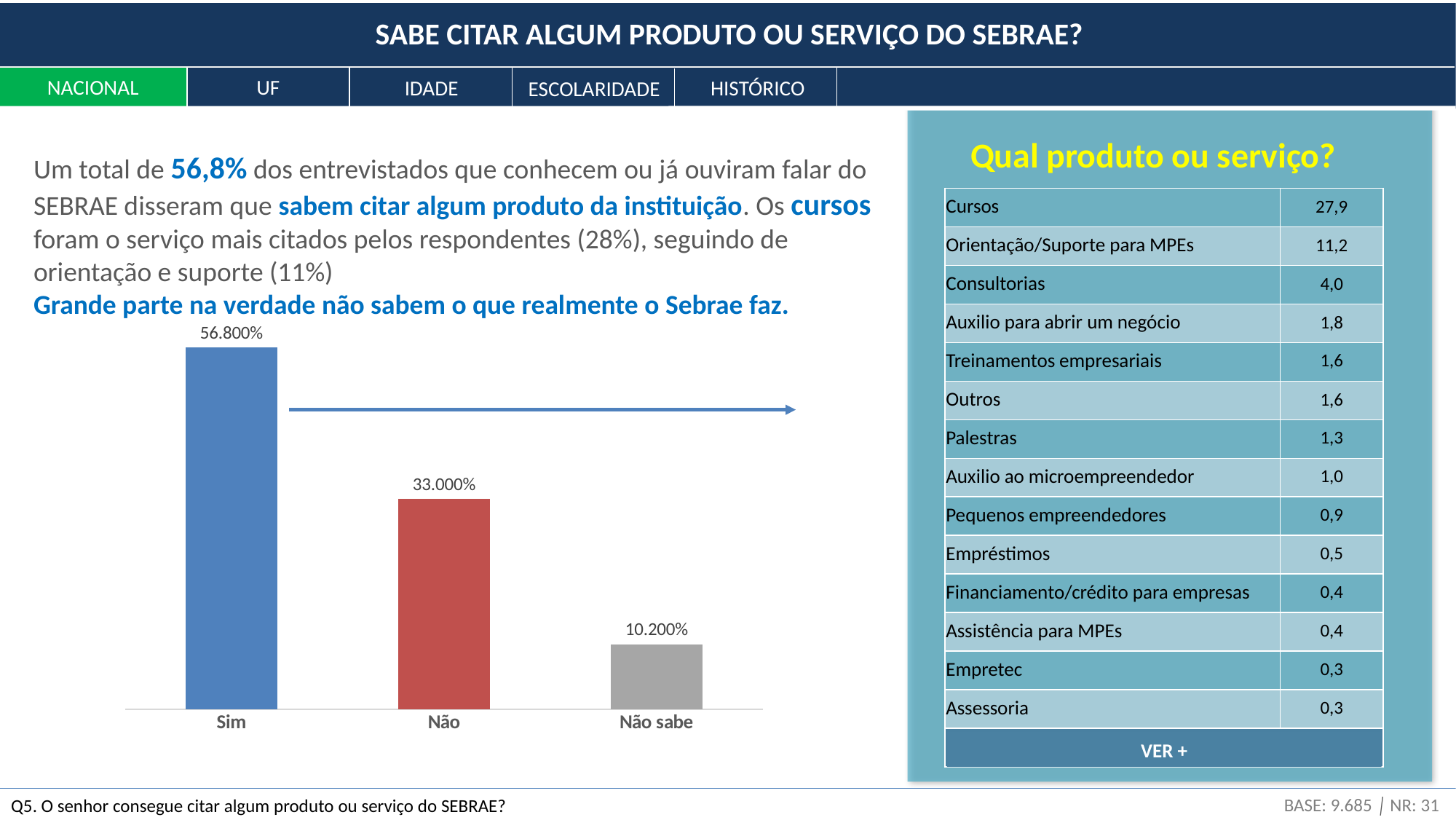
Which is larger in the bar chart, the value for "Não" or the value for "Não sabe"? Não What is the difference between the values for "Sim" and "Não" in the bar chart? 23.800% What is the value for "Não sabe" in the bar chart? 10.200% Which category has the highest value in the bar chart? Sim What is the value for "Não" in the bar chart? 33.000% How many categories are shown in the bar chart? 3 What is the value for "Sim" in the bar chart? 56.800% What kind of chart is shown on the slide? Bar chart What colour is the bar for "Não" in the bar chart? Red Which category has the lowest value in the bar chart? Não sabe What is the difference between the values for "Não" and "Não sabe" in the bar chart? 22.800% Do the values in the bar chart rise or fall from left to right? Fall